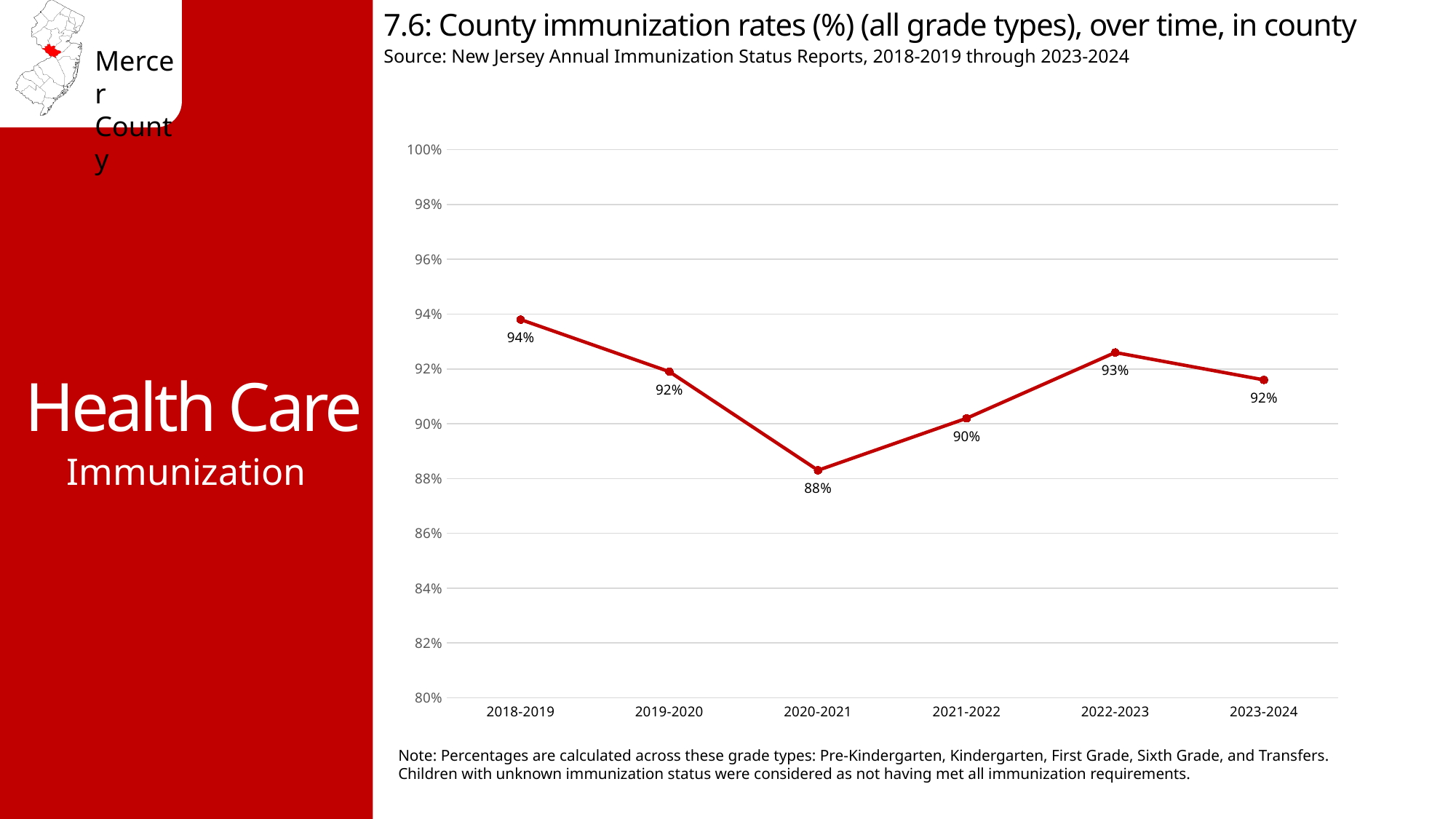
Which year has a higher immunization rate, 2021-2022 or 2022-2023? 2022-2023 What is the county immunization rate for 2021-2022? 90% What is the county immunization rate for 2018-2019? 94% What kind of chart is shown on the slide? line chart What is the county immunization rate for 2020-2021? 88% Did the immunization rate rise or fall from 2018-2019 to 2020-2021? fall What is the county immunization rate for 2022-2023? 93% Which school year has the highest immunization rate? 2018-2019 Is the immunization rate for 2020-2021 greater or less than 90%? less How many school years are plotted on the chart? 6 Which school year has the lowest immunization rate? 2020-2021 What is the difference in immunization rate between 2018-2019 and 2020-2021, using the printed labels? 6%